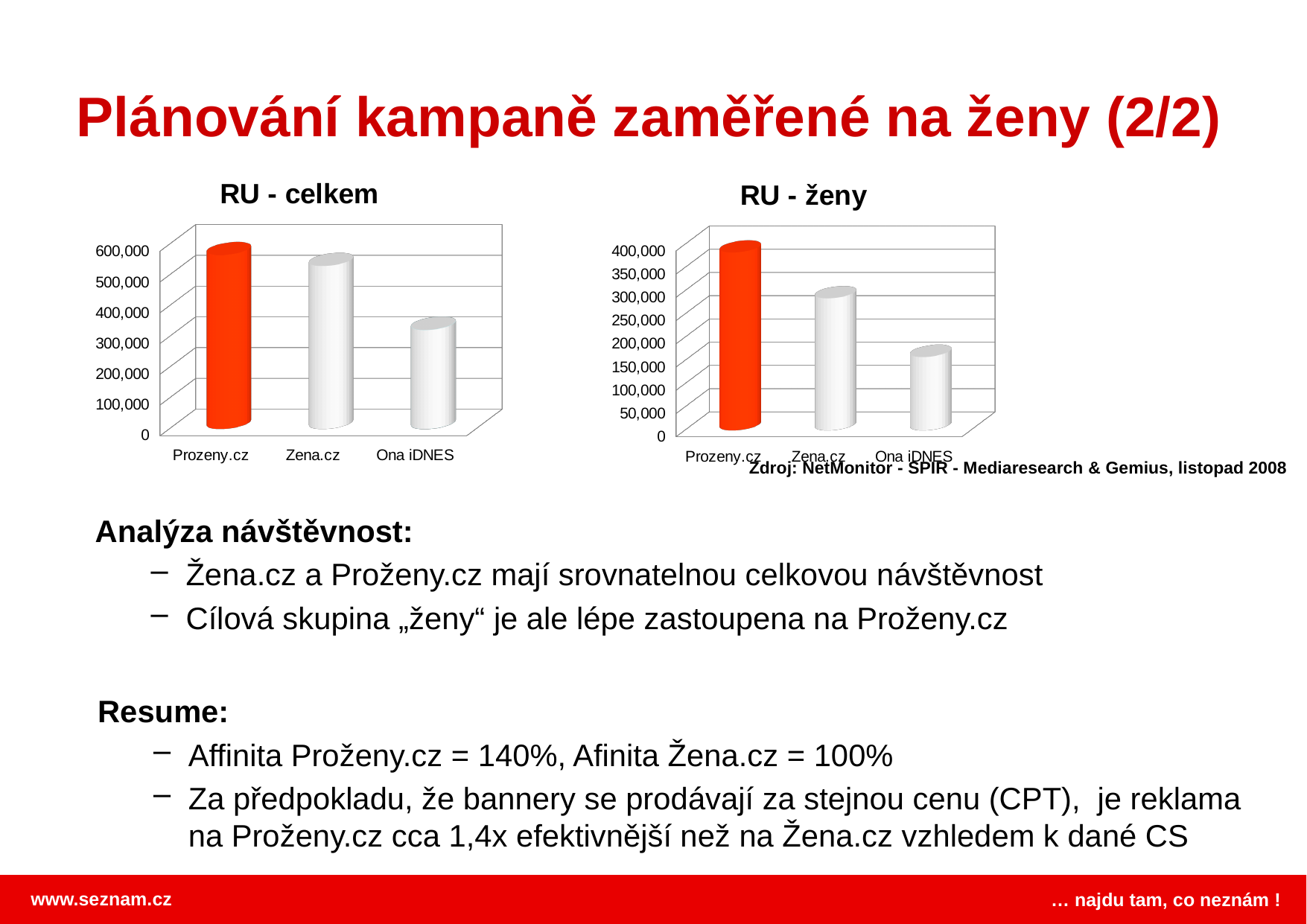
How many categories are shown on the "RU - ženy" chart? 3 On the "RU - ženy" chart, which category has the highest value? Prozeny.cz On the "RU - ženy" chart, is the value for Zena.cz larger or smaller than the value for Ona iDNES? larger On the "RU - celkem" chart, is the value for Ona iDNES greater or less than 400,000? less On the "RU - ženy" chart, is the value for Ona iDNES greater or less than 200,000? less On the "RU - ženy" chart, is the value for Zena.cz greater or less than 350,000? less On the "RU - celkem" chart, what colour is the bar for Prozeny.cz? red On the "RU - ženy" chart, which category has the lowest value? Ona iDNES What kind of chart is the "RU - celkem" chart? bar chart On the "RU - celkem" chart, which category has the lowest value? Ona iDNES